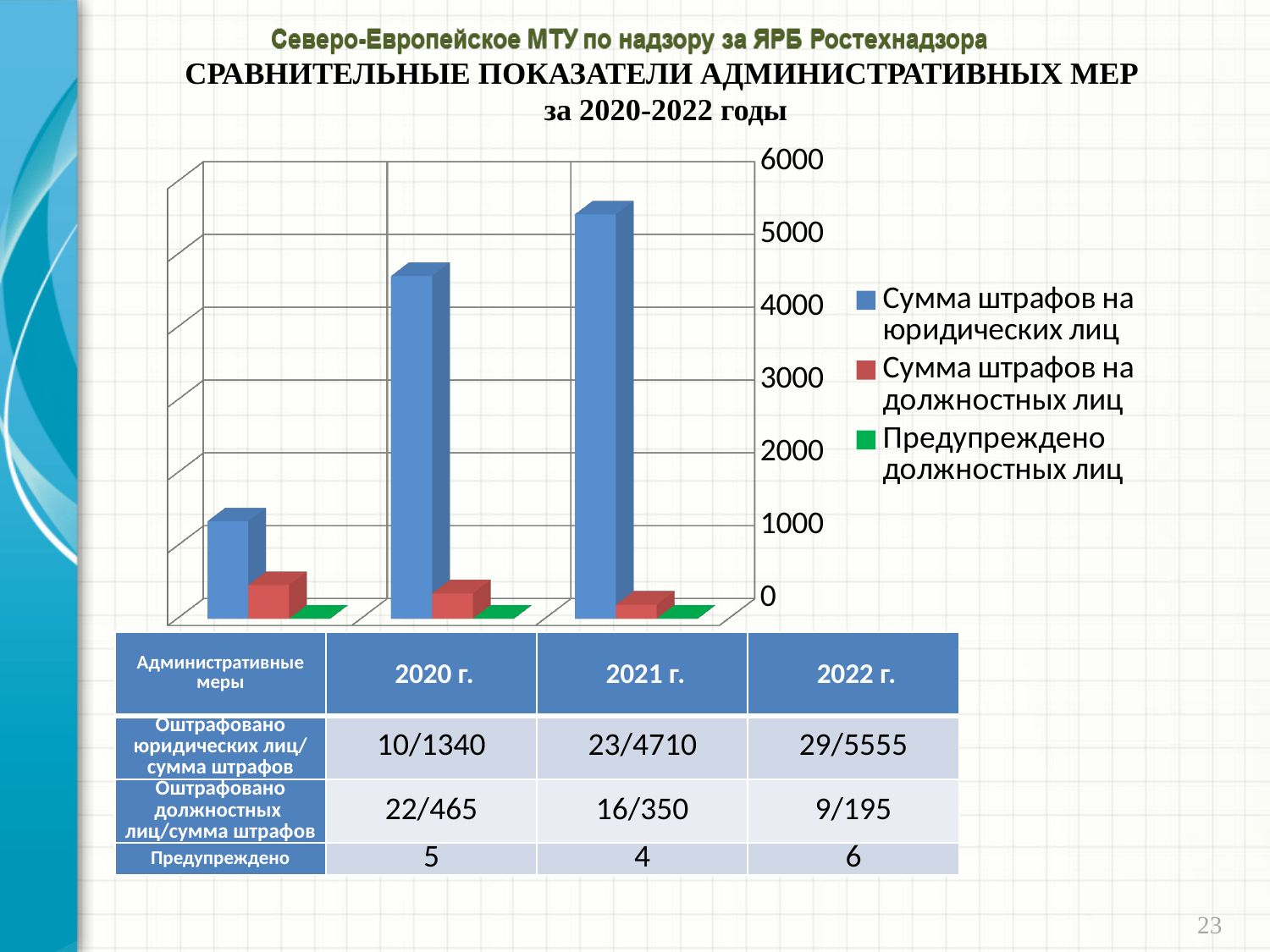
According to the table under the chart, what is the sum of fines on legal entities (сумма штрафов, юридических лиц) for 2022 г.? 5555 Which group of bars has the tallest blue bar (Сумма штрафов на юридических лиц)? the third group (2022 г.) Is the blue bar in the third group greater or less than 5000? greater Is the blue bar in the second group greater or less than 4000? greater How many groups of bars are plotted in the chart? 3 Which is larger: the red bar in the first group or the red bar in the third group? the first group How many series does the chart legend list? 3 Is the blue bar in the first group greater or less than 2000? less Which colour does the legend use for Предупреждено должностных лиц? green Do the red bars (Сумма штрафов на должностных лиц) rise or fall from left to right? fall Do the blue bars (Сумма штрафов на юридических лиц) rise or fall from left to right? rise What kind of chart is shown on the slide? bar chart